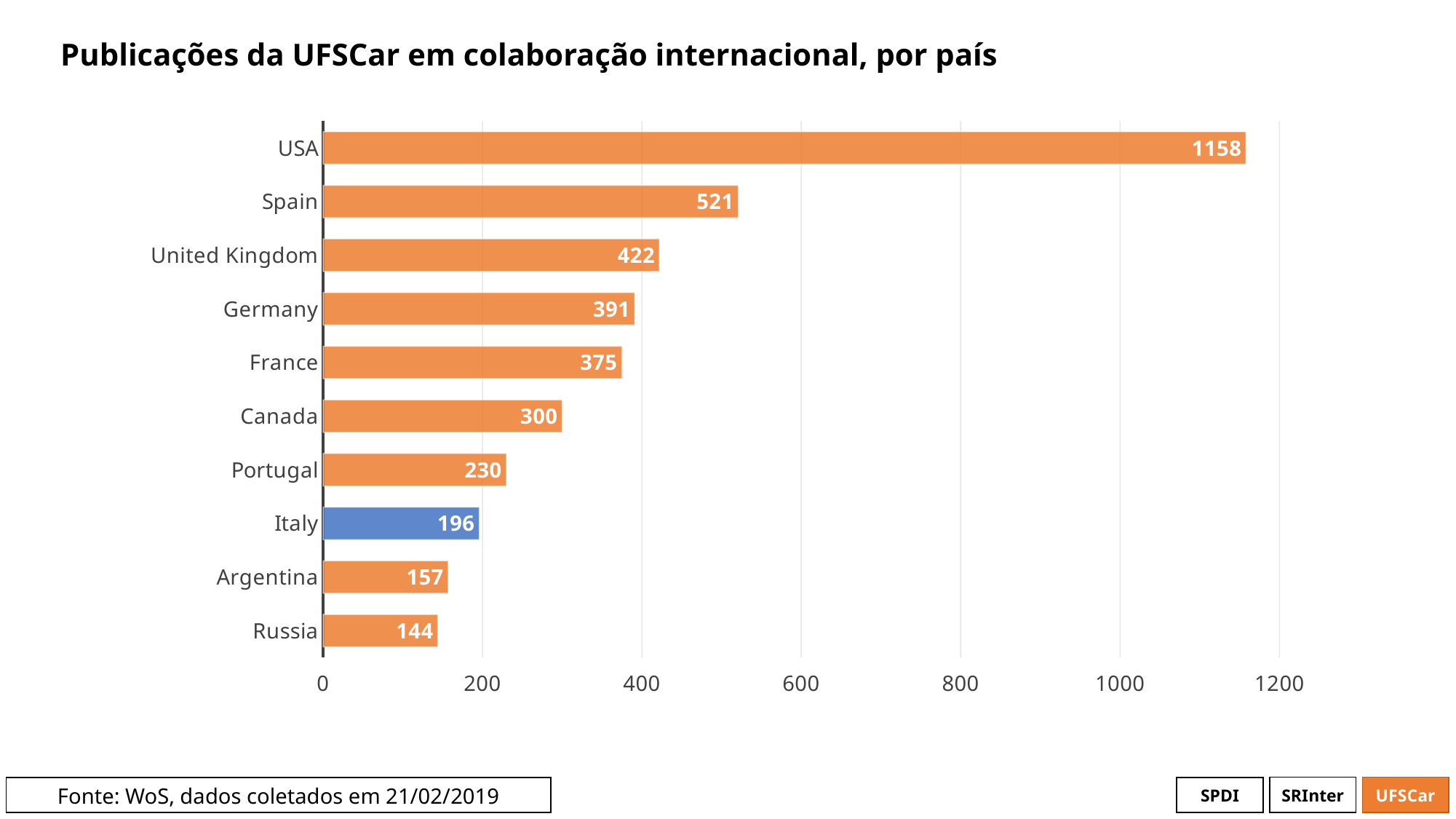
What is the difference between the values for Canada and Portugal? 70 Which country has the lowest value? Russia Which is larger, the value for France or the value for Canada? France How many countries are shown in the chart? 10 What is the value for Germany? 391 What is the difference between the values for Spain and United Kingdom? 99 Is the value for Argentina greater or less than 200? less Which country's bar is coloured blue instead of orange? Italy What is the value for USA? 1158 What kind of chart is shown on the slide? bar chart Which country has the highest value? USA What is the value for Italy? 196